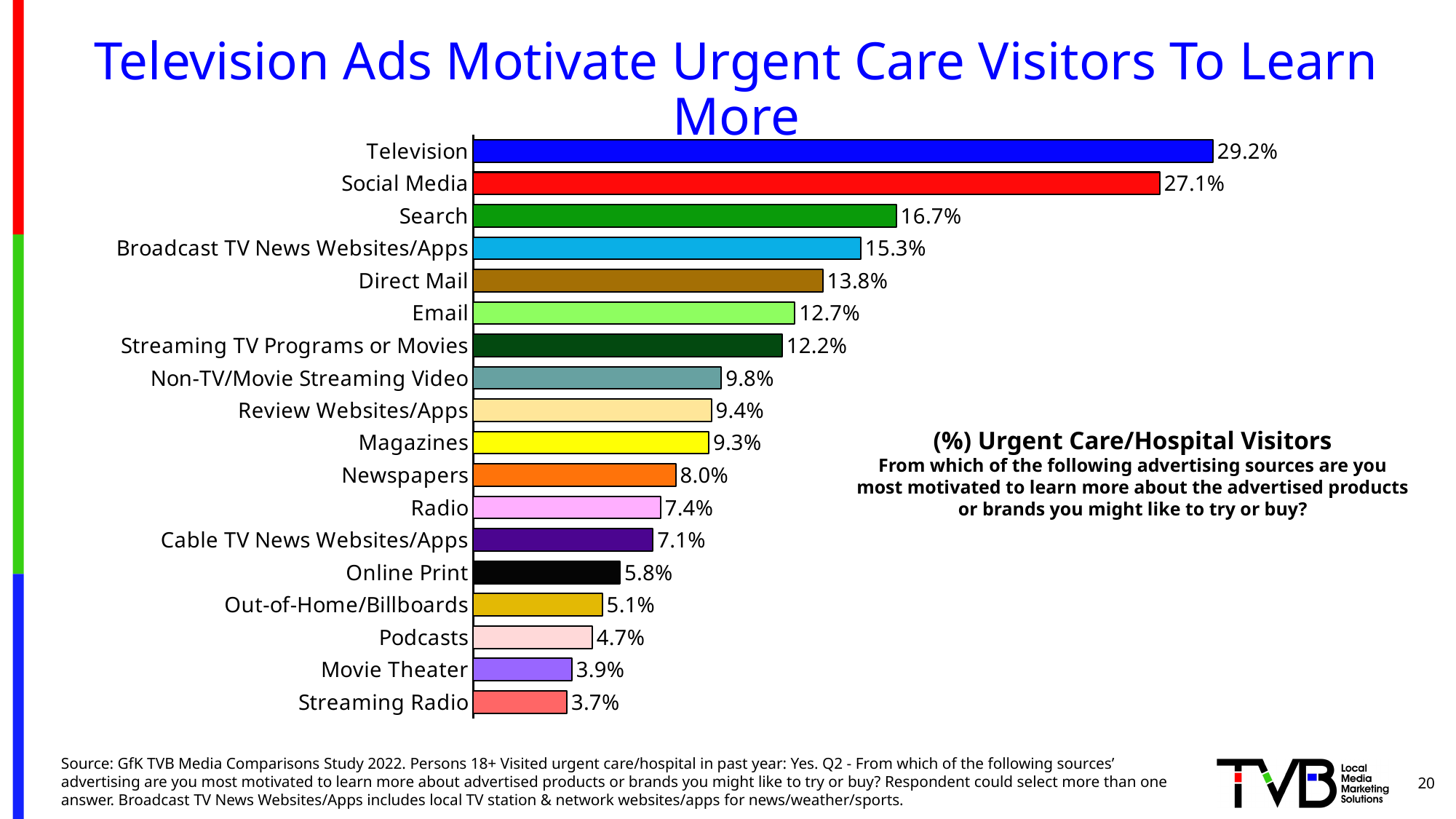
What colour is the bar for Social Media? Red What is the difference between the values for Search and Email? 4.0% What is the value shown for Direct Mail? 13.8% Which advertising source has the highest value on the chart? Television Which has a larger value, Newspapers or Radio? Newspapers What percentage of urgent care/hospital visitors are most motivated to learn more by Television ads? 29.2% Which advertising source has the lowest value on the chart? Streaming Radio What kind of chart is shown on the slide? Bar chart Which has a larger value, Online Print or Cable TV News Websites/Apps? Cable TV News Websites/Apps What is the value shown for Podcasts? 4.7% What is the difference between the values for Television and Social Media? 2.1% How many advertising sources are shown on the chart? 18